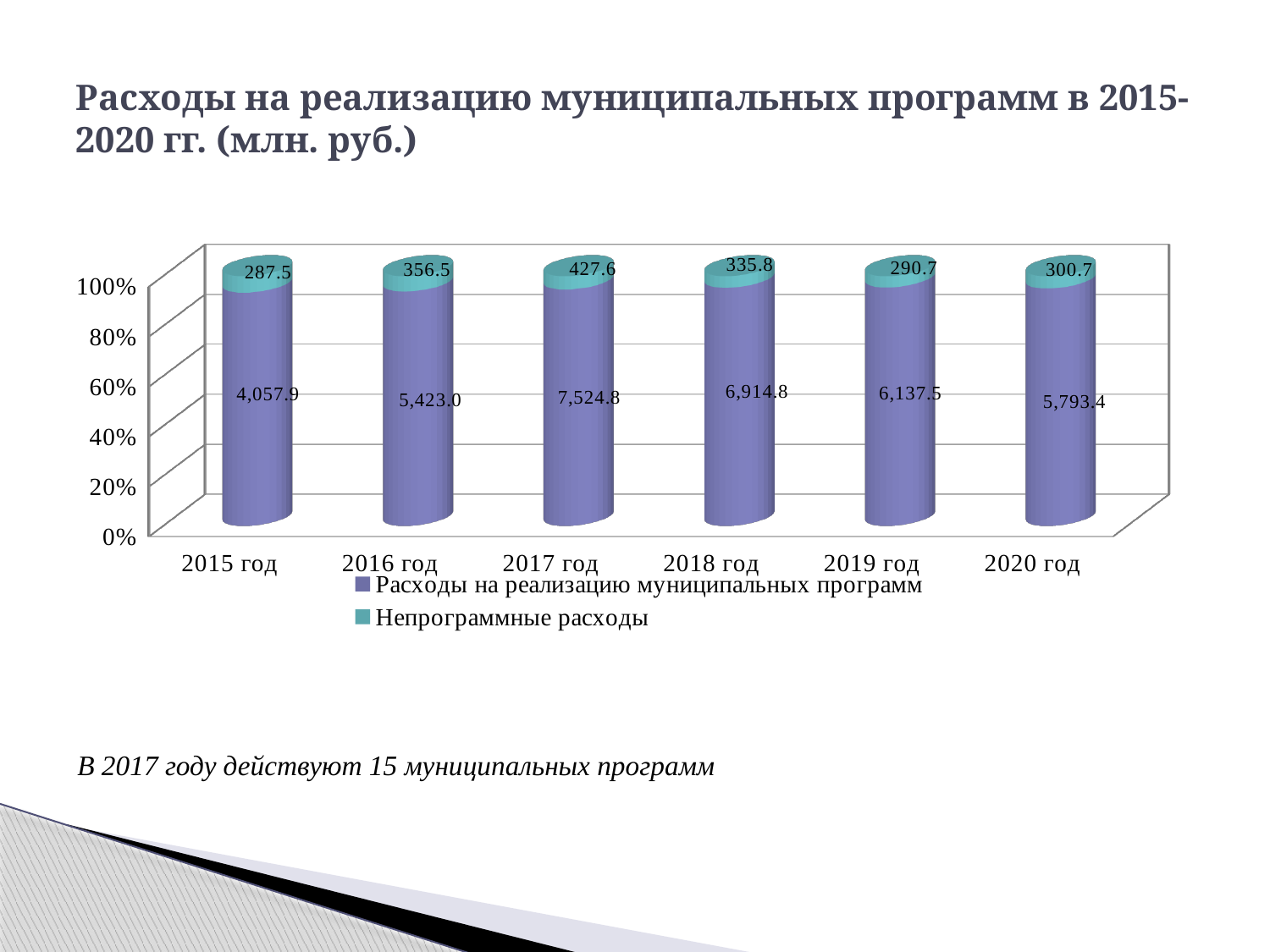
Do the values of «Расходы на реализацию муниципальных программ» rise or fall from 2017 год to 2020 год? Fall What is the value of «Расходы на реализацию муниципальных программ» for 2020 год? 5,793.4 What is the difference between «Расходы на реализацию муниципальных программ» in 2017 год and 2016 год? 2,101.8 What is the value of «Расходы на реализацию муниципальных программ» for 2017 год? 7,524.8 In which year is «Непрограммные расходы» the lowest? 2015 год What kind of chart is shown on the slide? Stacked bar chart How many years are shown on the x axis? 6 Which is larger: «Непрограммные расходы» in 2018 год or in 2019 год? 2018 год In which year is «Расходы на реализацию муниципальных программ» the highest? 2017 год How many series does the legend list? 2 What is the total of the two series for 2015 год? 4,345.4 What is the value of «Непрограммные расходы» for 2015 год? 287.5